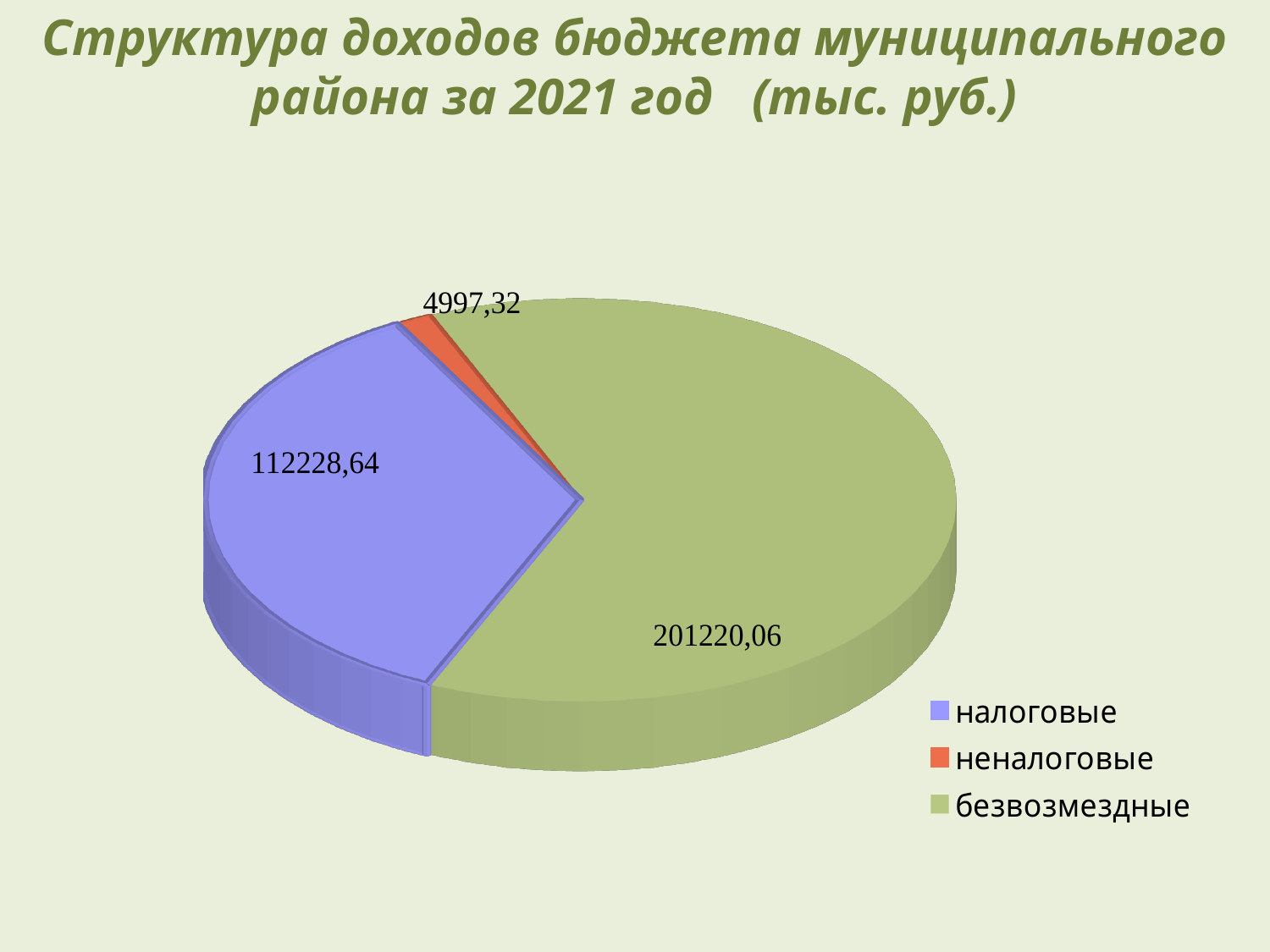
What is the total of all slices in the pie chart? 318446,02 Which is larger, the value for налоговые or the value for безвозмездные? безвозмездные What is the value for налоговые? 112228,64 Which category has the smallest slice of the pie? неналоговые What colour is the slice for неналоговые? red (orange-red) What is the value for неналоговые? 4997,32 What is the difference between the values for налоговые and неналоговые? 107231,32 Which category has the largest slice of the pie? безвозмездные What kind of chart is shown on the slide? pie chart What is the value for безвозмездные? 201220,06 What is the difference between the values for безвозмездные and налоговые? 88991,42 How many categories does the pie chart show? 3